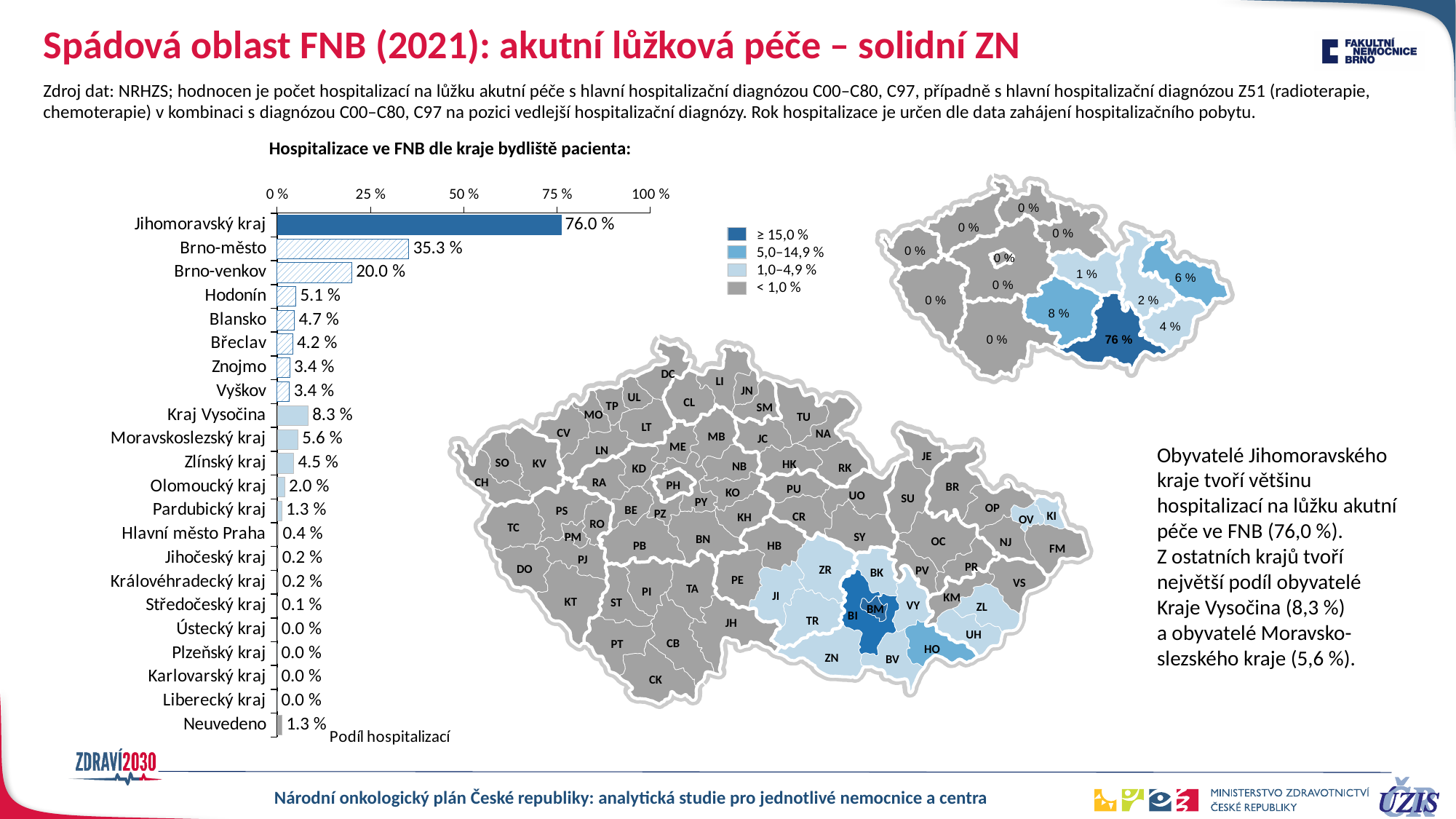
Is the value for Jihomoravský kraj in the bar chart greater or less than 75 %? greater What is the value for Moravskoslezský kraj in the bar chart? 5.6 % What is the value for Jihomoravský kraj in the bar chart? 76.0 % What is the title of the bar chart? Hospitalizace ve FNB dle kraje bydliště pacienta: Which has a larger value in the bar chart, Hodonín or Blansko? Hodonín What is the difference between the values for Brno-město and Brno-venkov in the bar chart? 15.3 % Which category has the highest value in the bar chart? Jihomoravský kraj What is the value for Kraj Vysočina in the bar chart? 8.3 % How many categories are shown in the bar chart? 22 Which has a larger value in the bar chart, Zlínský kraj or Olomoucký kraj? Zlínský kraj What is the value for Brno-venkov in the bar chart? 20.0 % What kind of chart is shown on the left of the slide? bar chart